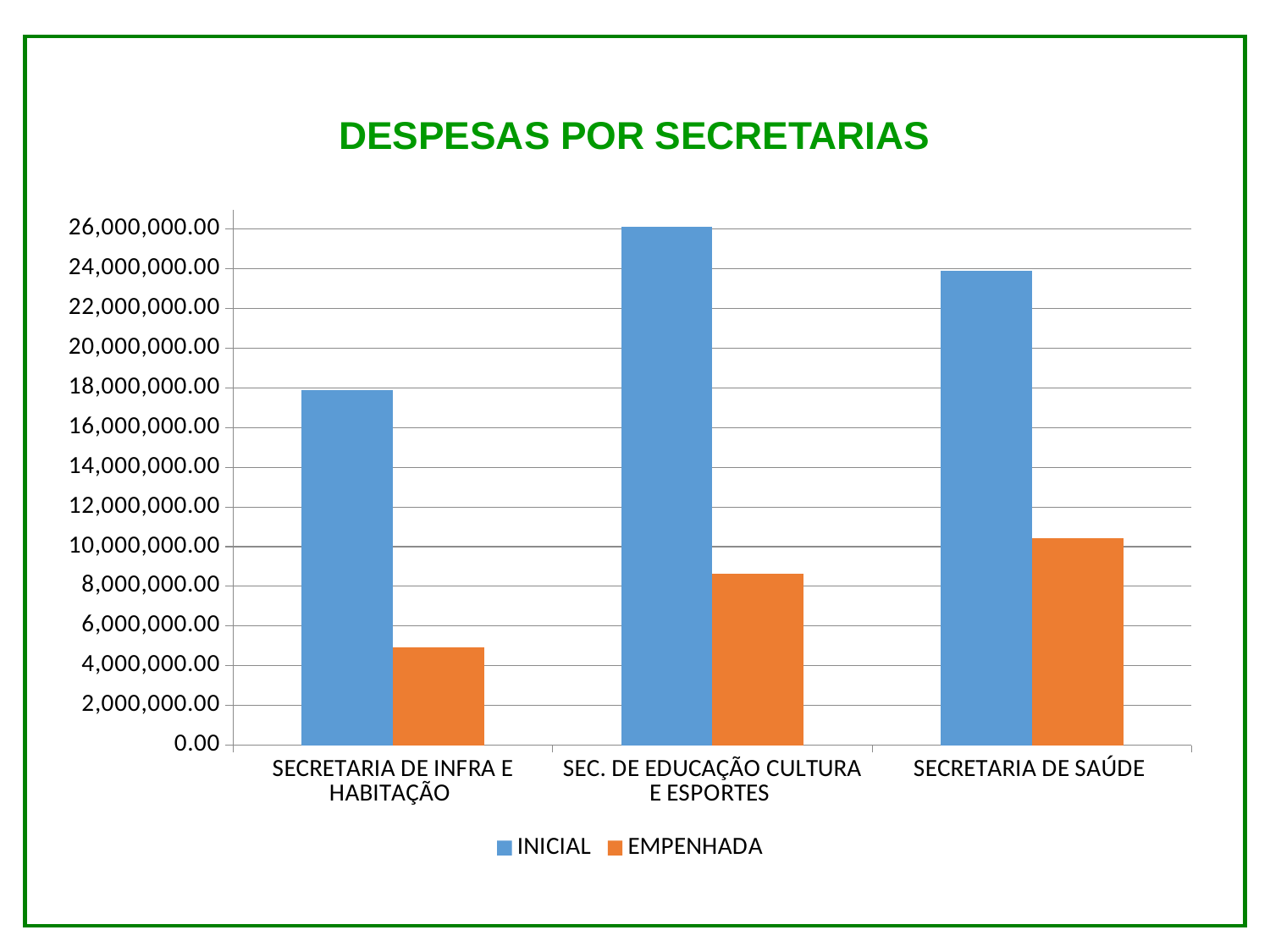
Which category has the lowest EMPENHADA value? SECRETARIA DE INFRA E HABITAÇÃO Is the INICIAL value for SECRETARIA DE INFRA E HABITAÇÃO greater or less than 16,000,000.00? greater Is the EMPENHADA value for SECRETARIA DE INFRA E HABITAÇÃO greater or less than 6,000,000.00? less What kind of chart is shown on the slide? bar chart Is the EMPENHADA value for SECRETARIA DE SAÚDE greater or less than 12,000,000.00? less Which category has the highest INICIAL value? SEC. DE EDUCAÇÃO CULTURA E ESPORTES Which category has the highest EMPENHADA value? SECRETARIA DE SAÚDE How many series does the legend list? 2 What is the title of the chart? DESPESAS POR SECRETARIAS How many categories are shown on the x axis? 3 Which is larger for SECRETARIA DE SAÚDE, the INICIAL value or the EMPENHADA value? INICIAL